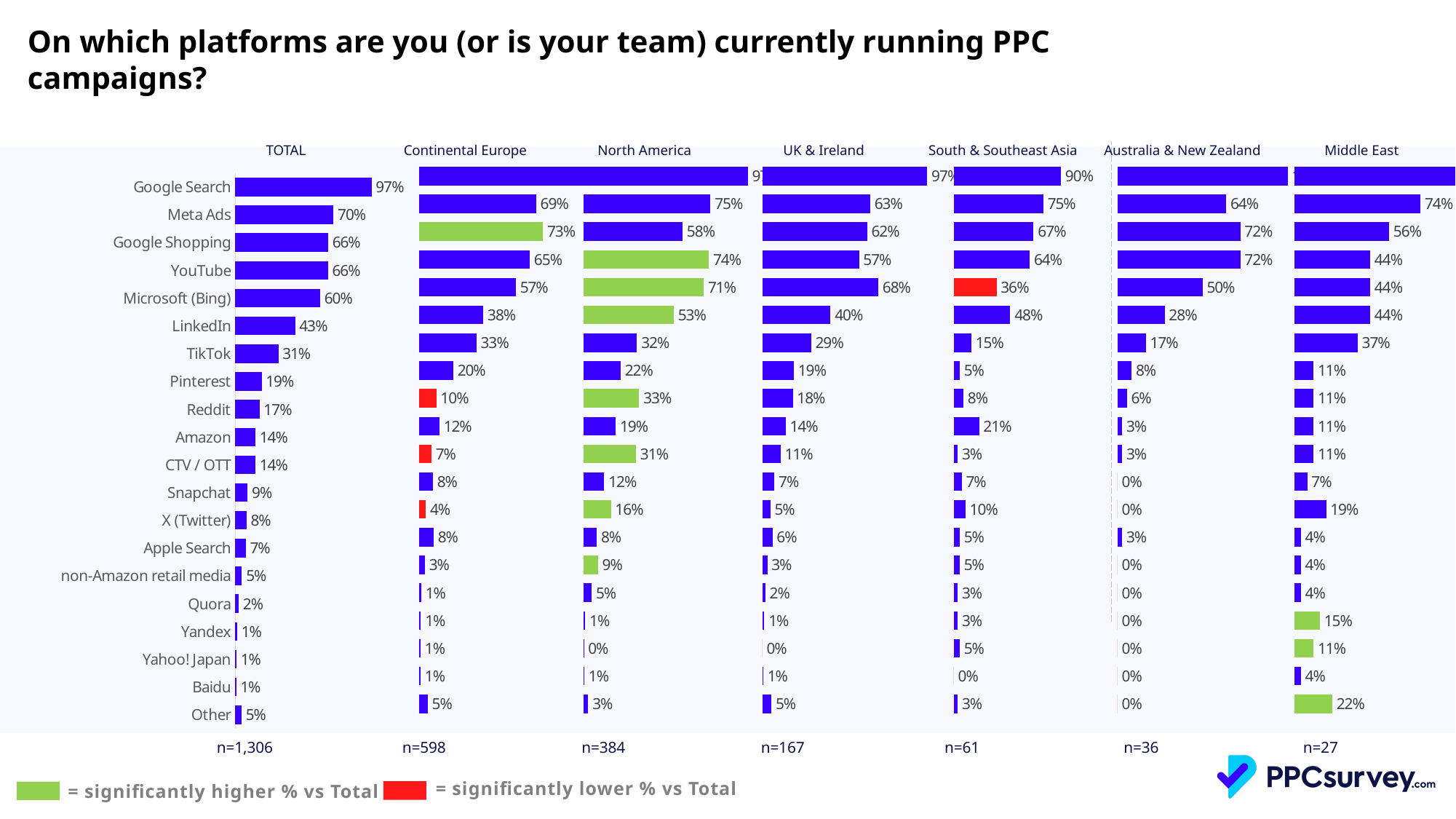
According to the legend, what does a green bar indicate? Significantly higher % vs Total In the North America chart, what percentage is shown for Reddit? 33% In the Middle East chart, what percentage is shown for Other? 22% What kind of chart is used on this slide? Bar chart For YouTube, which region has the higher value: Australia & New Zealand or Middle East? Australia & New Zealand In the TOTAL chart, what is the difference between the Meta Ads value and the Google Shopping value? 4 percentage points In the TOTAL chart, what percentage is shown for Google Search? 97% For Google Shopping, which region has the higher value: Continental Europe or North America? Continental Europe In the South & Southeast Asia chart, what percentage is shown for Microsoft (Bing)? 36% What is the sample size (n) shown for the North America chart? n=384 How many platforms are listed as categories in the charts? 20 In the UK & Ireland chart, which platform has the highest value? Google Search